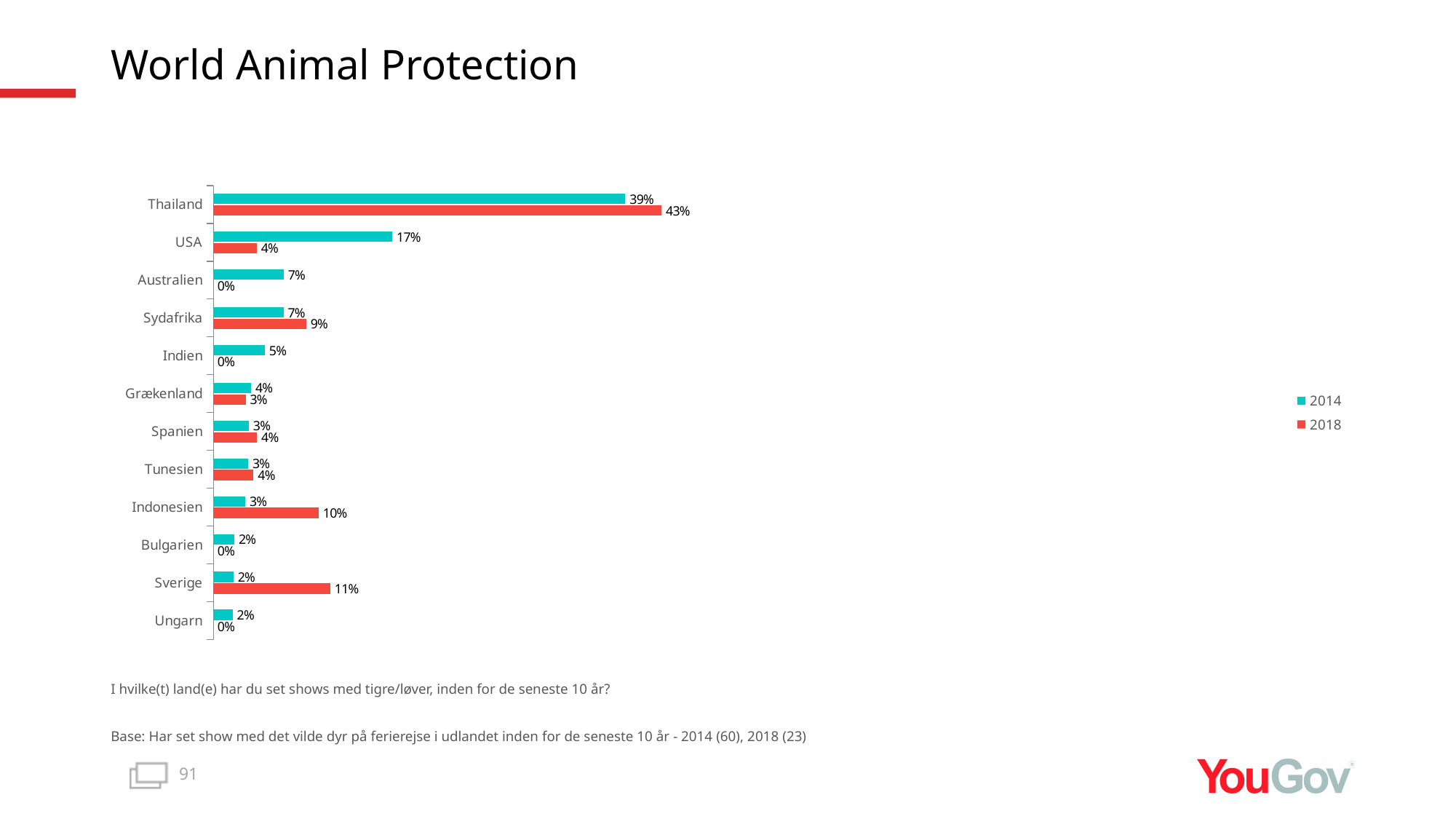
What is the difference between the 2014 and 2018 values for USA? 13% Which country has the highest 2014 value? Thailand Which is larger for Sydafrika, the 2014 value or the 2018 value? 2018 Which country has the highest 2018 value? Thailand What is the difference between the 2018 and 2014 values for Indonesien? 7% How many series does the legend list? 2 Which colour represents the 2018 series in the legend? Red What kind of chart is shown on the slide? Bar chart What is the 2018 value for Sverige? 11% What is the 2018 value for Thailand? 43% What is the 2014 value for USA? 17% How many countries are shown on the chart? 12